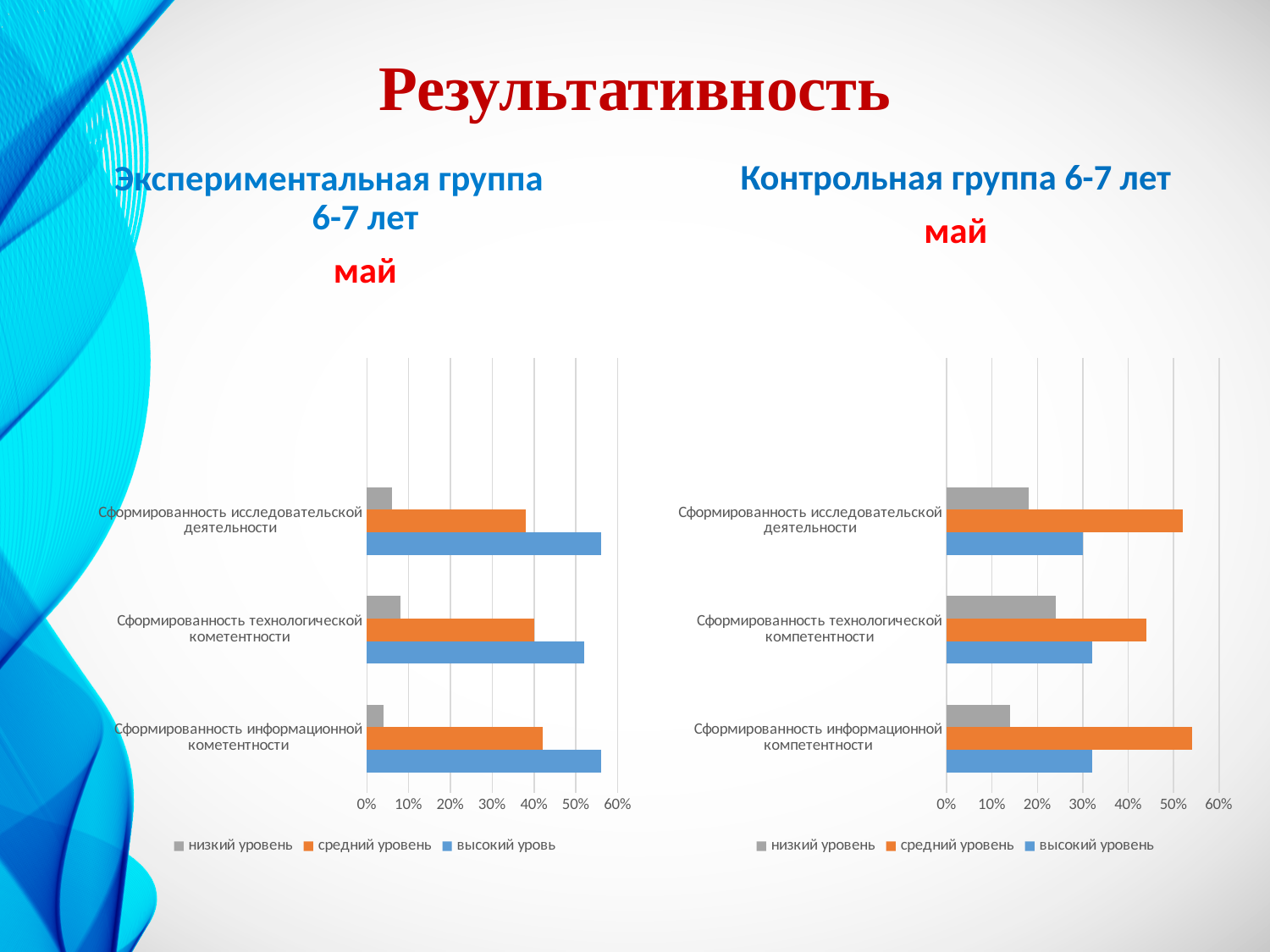
Which series is shown in orange on the right chart ('Контрольная группа 6-7 лет')? средний уровень On the right chart ('Контрольная группа 6-7 лет'), which category has the highest value for 'низкий уровень'? Сформированность технологической компетентности On the right chart ('Контрольная группа 6-7 лет'), for 'Сформированность исследовательской деятельности', which is larger: 'средний уровень' or 'высокий уровень'? средний уровень What kind of chart is the 'Экспериментальная группа 6-7 лет' chart on the left? bar chart On the right chart ('Контрольная группа 6-7 лет'), is the value of 'средний уровень' for 'Сформированность информационной компетентности' greater or less than 50%? greater How many categories are shown on the 'Контрольная группа 6-7 лет' chart on the right? 3 On the left chart ('Экспериментальная группа 6-7 лет'), for 'Сформированность технологической компетентности', which is larger: 'средний уровень' or 'высокий уровень'? высокий уровень On the right chart ('Контрольная группа 6-7 лет'), is the value of 'низкий уровень' for 'Сформированность технологической компетентности' greater or less than 20%? greater How many series does the legend of the left chart ('Экспериментальная группа 6-7 лет') list? 3 On the left chart ('Экспериментальная группа 6-7 лет'), is the value of 'высокий уровень' for 'Сформированность исследовательской деятельности' greater or less than 50%? greater